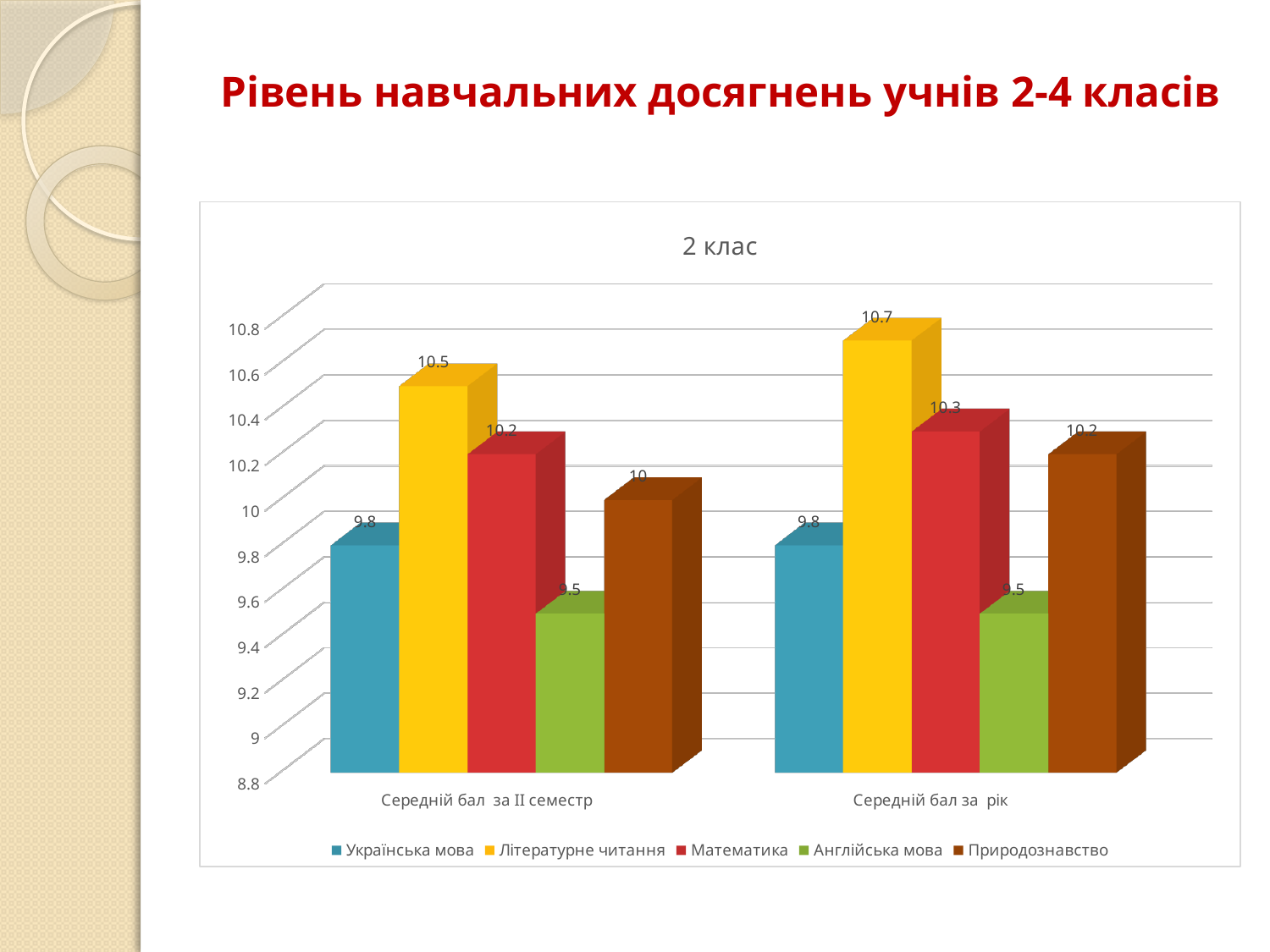
What is the value for Математика in the 'Середній бал за II семестр' category? 10.2 What is the difference between the Літературне читання values for 'Середній бал за рік' and 'Середній бал за II семестр'? 0.2 Is the value for Українська мова in 'Середній бал за рік' greater or less than 10? less Which series has the highest value in the 'Середній бал за рік' category? Літературне читання Which is larger: Математика for 'Середній бал за рік' or Природознавство for 'Середній бал за рік'? Математика What is the value for Природознавство in the 'Середній бал за II семестр' category? 10 What kind of chart is shown on the slide? bar chart What is the title of the chart? 2 клас How many categories are shown on the x axis? 2 What is the value for Літературне читання in the 'Середній бал за рік' category? 10.7 Which series has the lowest value in the 'Середній бал за II семестр' category? Англійська мова How many series does the legend list? 5